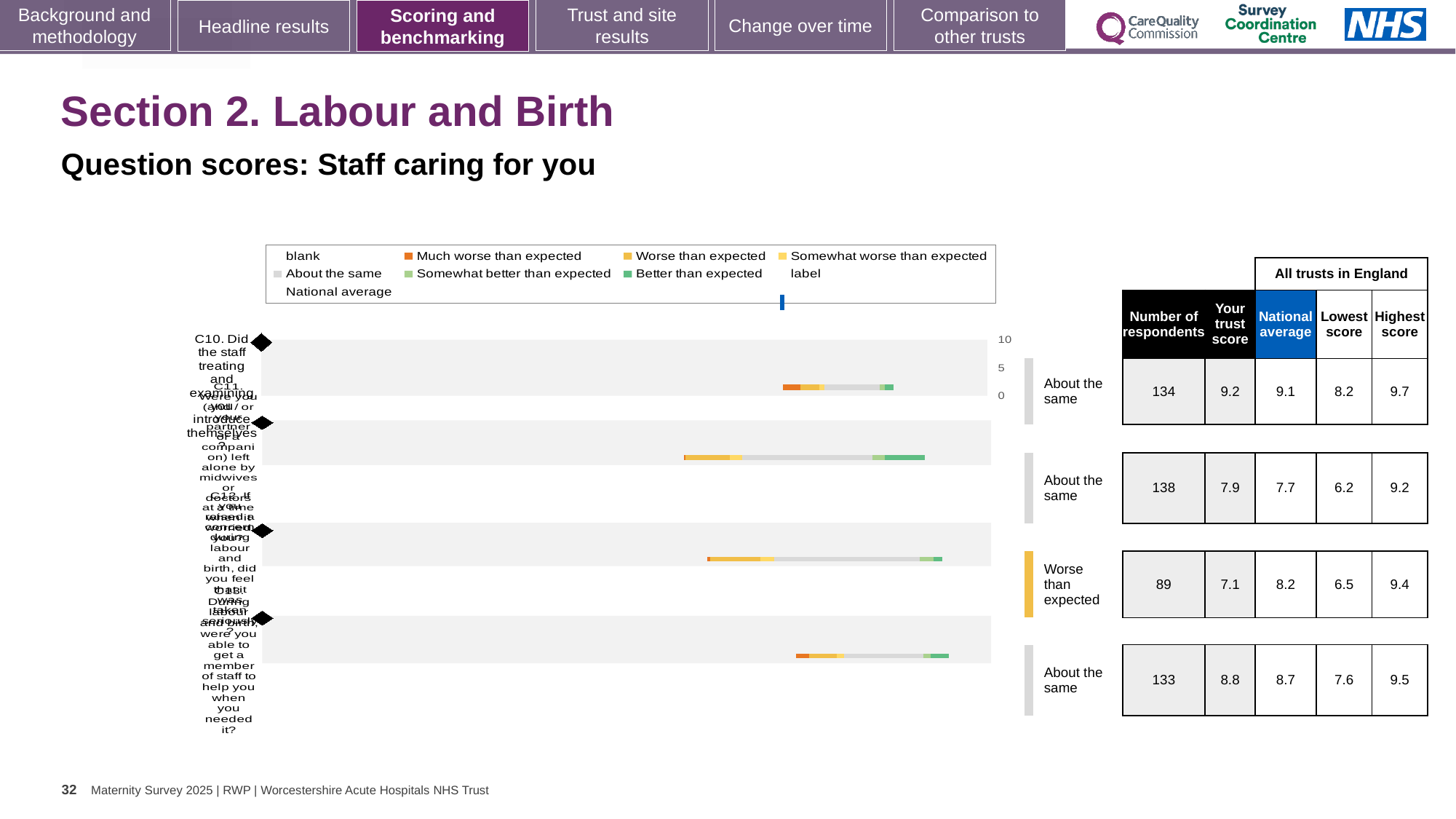
What is the highest score across all trusts in England for the fourth question row (C13)? 9.5 What kind of chart is shown on the slide? Bar chart Which question row is rated 'Worse than expected'? The third row (C12) For the second question row (C11), what is the difference between the highest score and the lowest score across all trusts in England? 3.0 Which question row has the highest 'Your trust score'? The first row (C10), 9.2 For the third question row (C12), which is larger: the trust score or the national average? The national average (8.2) What is the subtitle describing the question scores shown on the slide? Question scores: Staff caring for you How many question rows are plotted on the chart? 4 What is the 'Your trust score' for the fourth question row (C13, getting a member of staff to help you when you needed it)? 8.8 What is the national average for the third question row (C12)? 8.2 How many respondents are shown for the first question row (C10) in the table beside the chart? 134 Which question row has the lowest number of respondents? The third row (C12), 89